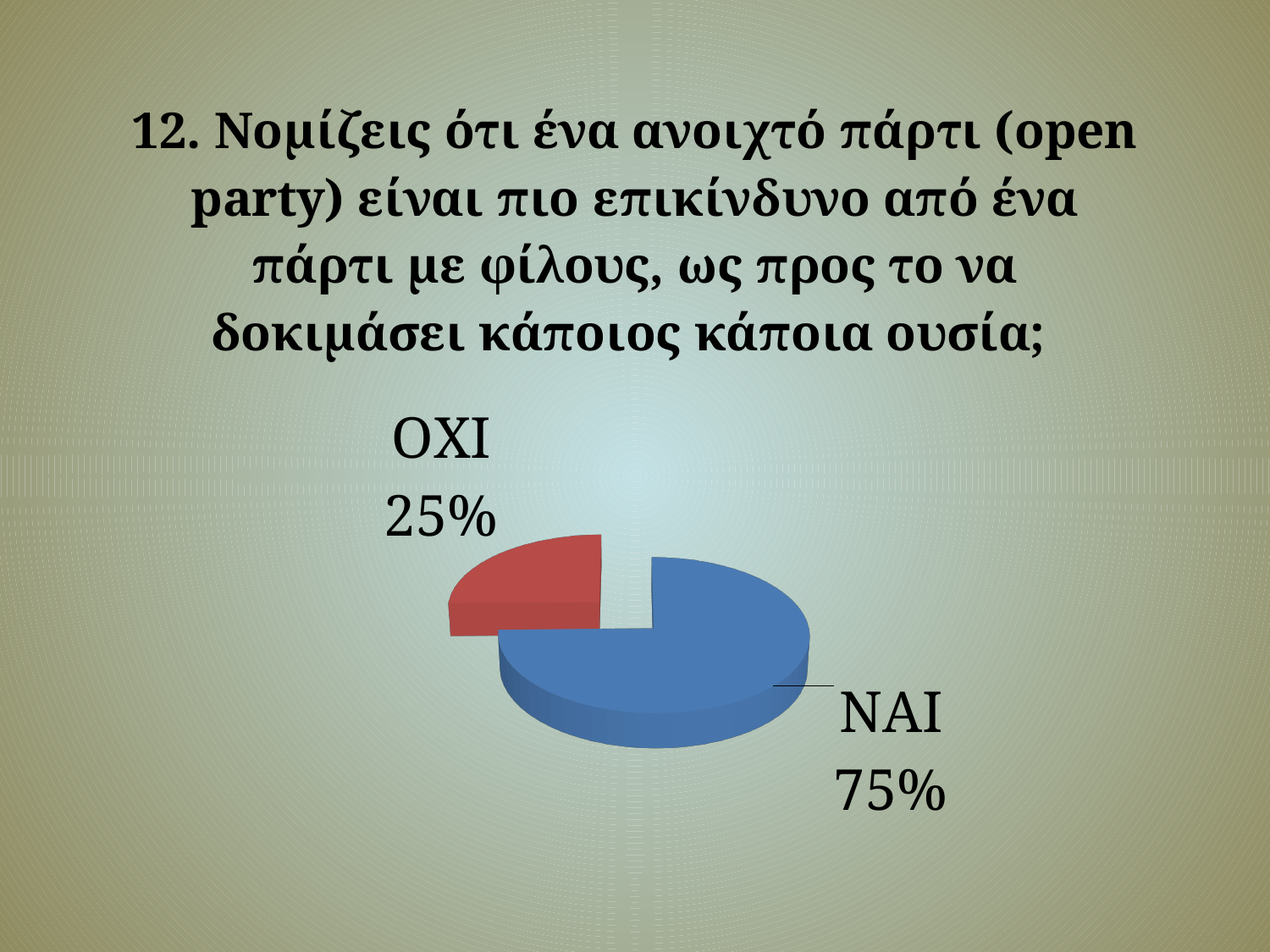
What colour is the ΟΧΙ slice? red Which slice is the largest in the pie chart? ΝΑΙ Which slice is the smallest in the pie chart? ΟΧΙ What kind of chart is shown on the slide? pie chart Which is larger, the ΝΑΙ slice or the ΟΧΙ slice? ΝΑΙ What is the difference in percentage points between the ΝΑΙ and ΟΧΙ slices? 50 What share of the pie does the ΟΧΙ slice represent? 25% How many slices does the pie chart have? 2 What percentage of the pie is the ΟΧΙ slice? 25% What colour is the ΝΑΙ slice? blue What percentage of the pie is the ΝΑΙ slice? 75%